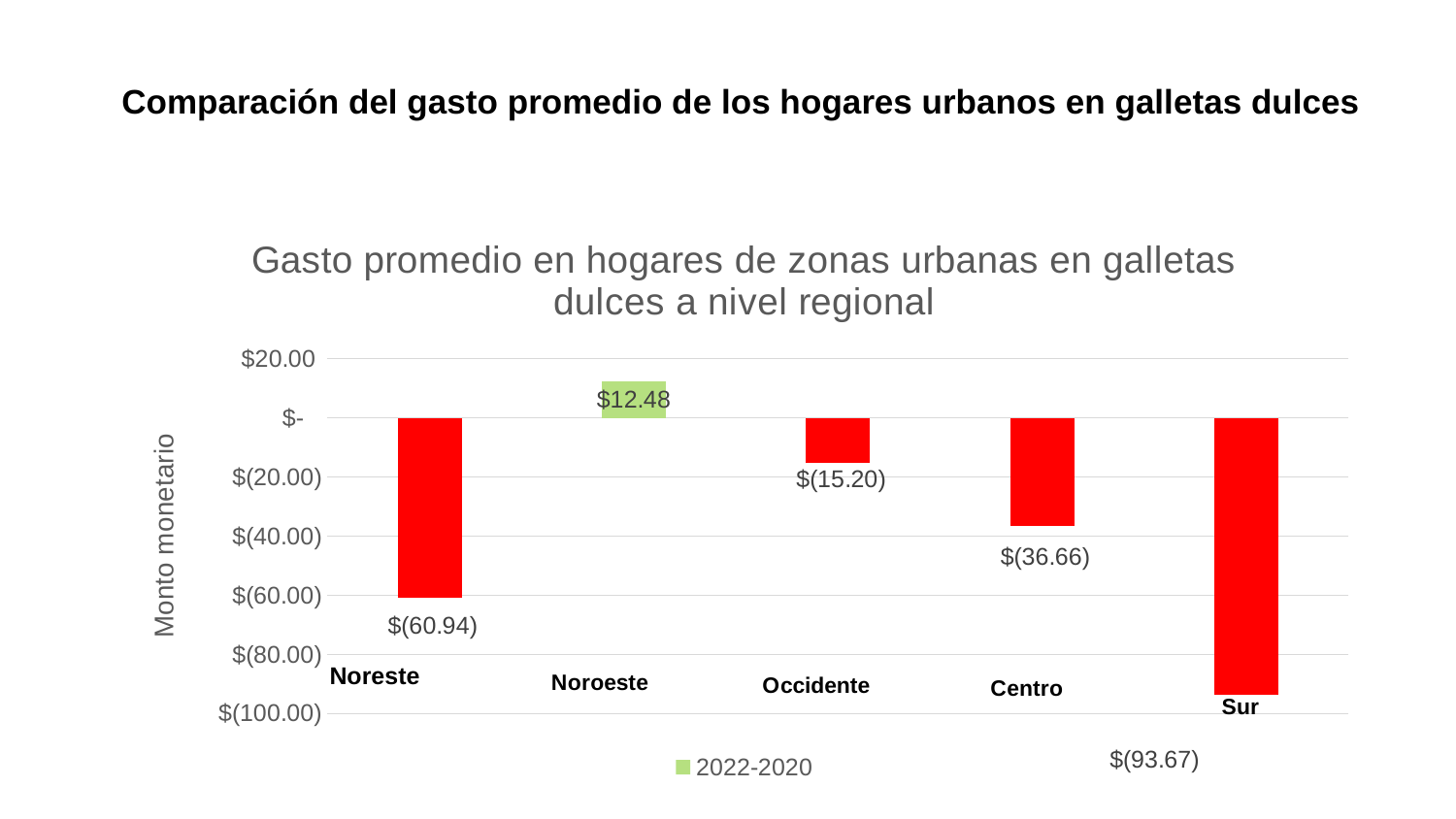
What is the value for Noroeste? $12.48 Which region has the highest value? Noroeste Which region has the lowest value? Sur What is the value for Noreste? $(60.94) What is the legend entry shown below the chart? 2022-2020 How many series does the legend list? 1 What is the value for Occidente? $(15.20) Which is larger, the value for Occidente or the value for Centro? Occidente What is the value for Sur? $(93.67) What is the value for Centro? $(36.66) What kind of chart is shown? Bar chart How many regions are shown on the x axis? 5